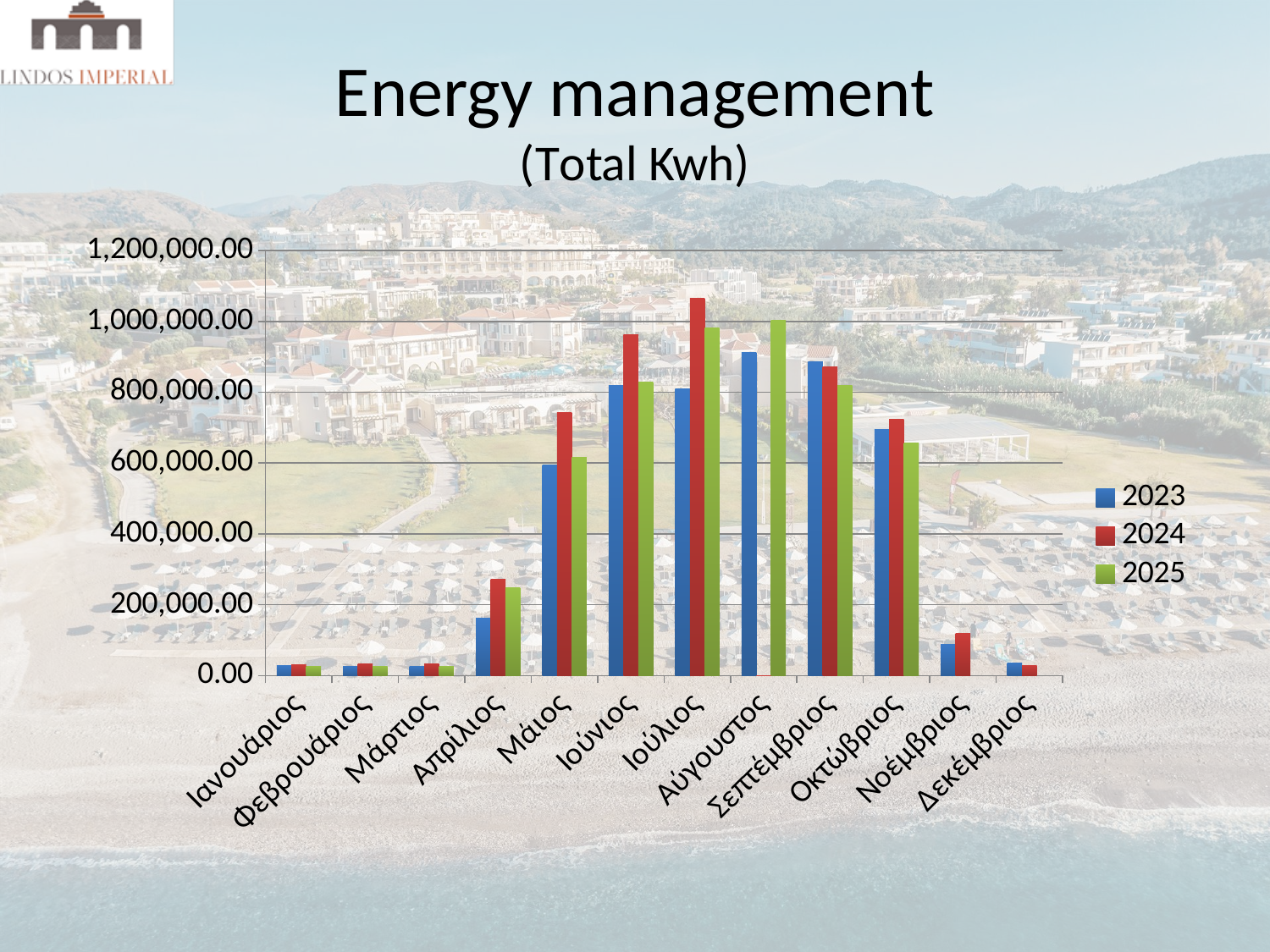
How many months (categories) are shown on the x axis? 12 For Μάιος, which series has the larger value, 2023 or 2024? 2024 What kind of chart is shown on the slide? bar chart Is the 2025 value for Οκτώβριος greater or less than 800,000.00? less Is the 2024 value for Μάιος greater or less than 600,000.00? greater Is the 2023 value for Απρίλιος greater or less than 200,000.00? less Which month has the highest value for the 2024 series? Ιούλιος What are the entries listed in the chart legend? 2023, 2024, 2025 For Ιούλιος, which series has the larger value, 2023 or 2024? 2024 How many series does the legend list? 3